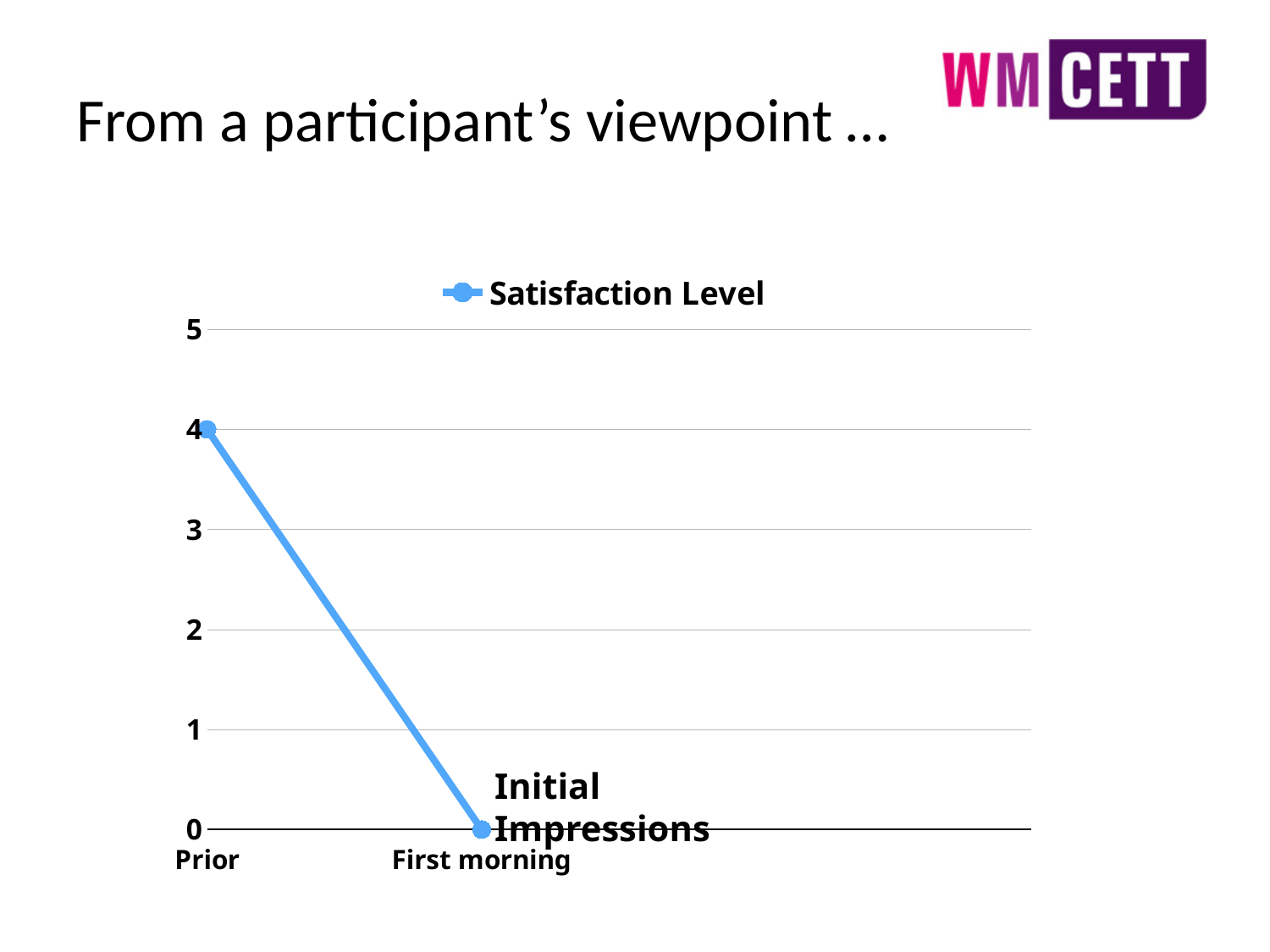
What is the Satisfaction Level value for First morning? 0 Which category has the lowest Satisfaction Level? First morning Is the Satisfaction Level for Prior greater or less than 3? greater Which is larger, the Satisfaction Level for Prior or for First morning? Prior How many series does the legend list? 1 What is the difference in Satisfaction Level between Prior and First morning? 4 Which category has the highest Satisfaction Level? Prior Does the Satisfaction Level rise or fall from Prior to First morning? fall How many categories are plotted on the x axis? 2 What is the Satisfaction Level value for Prior? 4 What is the name of the series shown in the legend? Satisfaction Level What kind of chart is shown on the slide? line chart